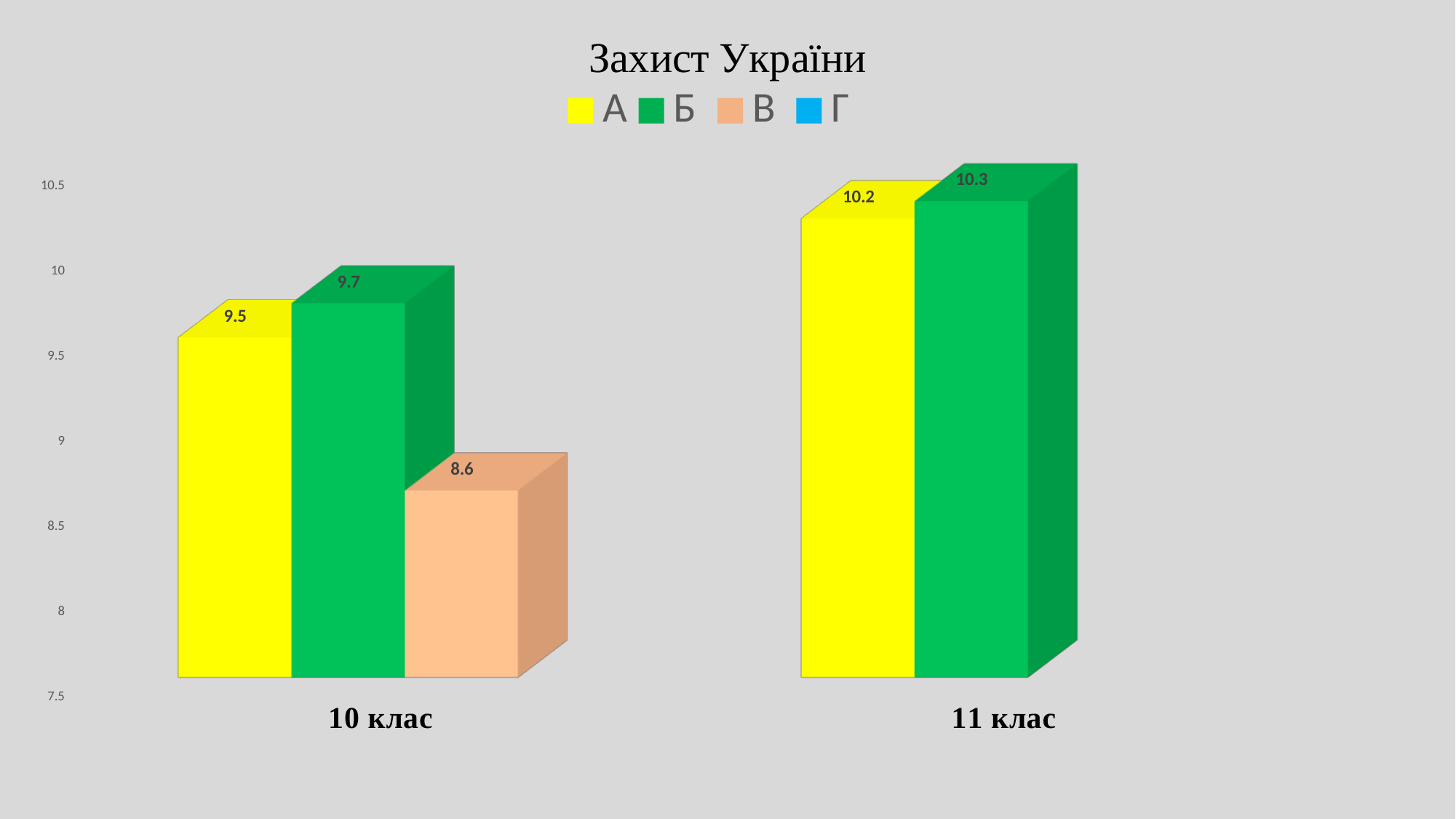
How many series does the legend list? 4 What is the value for series Б in the 11 клас category? 10.3 Which bar has the highest value on the chart? Б in 11 клас How many categories are shown on the x axis? 2 Which is larger: series А in 10 клас or series Б in 10 клас? Б in 10 клас What is the difference between series Б and series В in the 10 клас category? 1.1 What is the title of the chart? Захист України What is the value for series В in the 10 клас category? 8.6 Which series has the lowest value in the 10 клас category? В What is the value for series А in the 10 клас category? 9.5 What is the difference between series А in 11 клас and series А in 10 клас? 0.7 What is the value for series А in the 11 клас category? 10.2